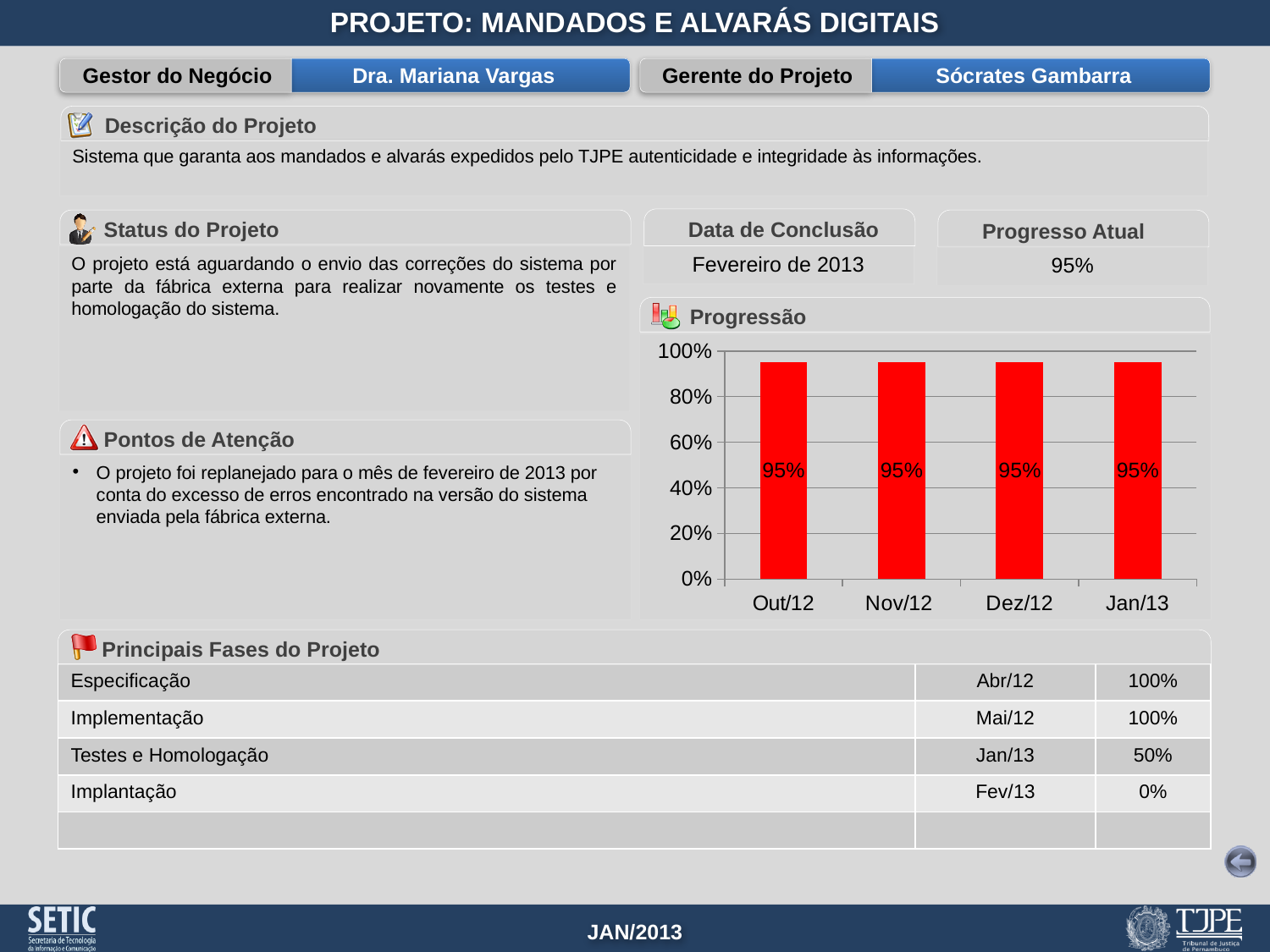
Is the value for Nov/12 in the Progressão chart greater or less than 100%? less What is the value for Out/12 in the Progressão chart? 95% How many categories are shown on the x axis of the Progressão chart? 4 What is the difference between the values for Out/12 and Jan/13 in the Progressão chart? 0% What is the value for Jan/13 in the Progressão chart? 95% What colour are the bars in the Progressão chart? red What is the title of the chart on the slide? Progressão What is the value for Dez/12 in the Progressão chart? 95% What is the value for Nov/12 in the Progressão chart? 95% What kind of chart is the Progressão chart? bar chart Do the values in the Progressão chart rise, fall or stay the same from Out/12 to Jan/13? stay the same Is the value for Dez/12 in the Progressão chart greater or less than 80%? greater